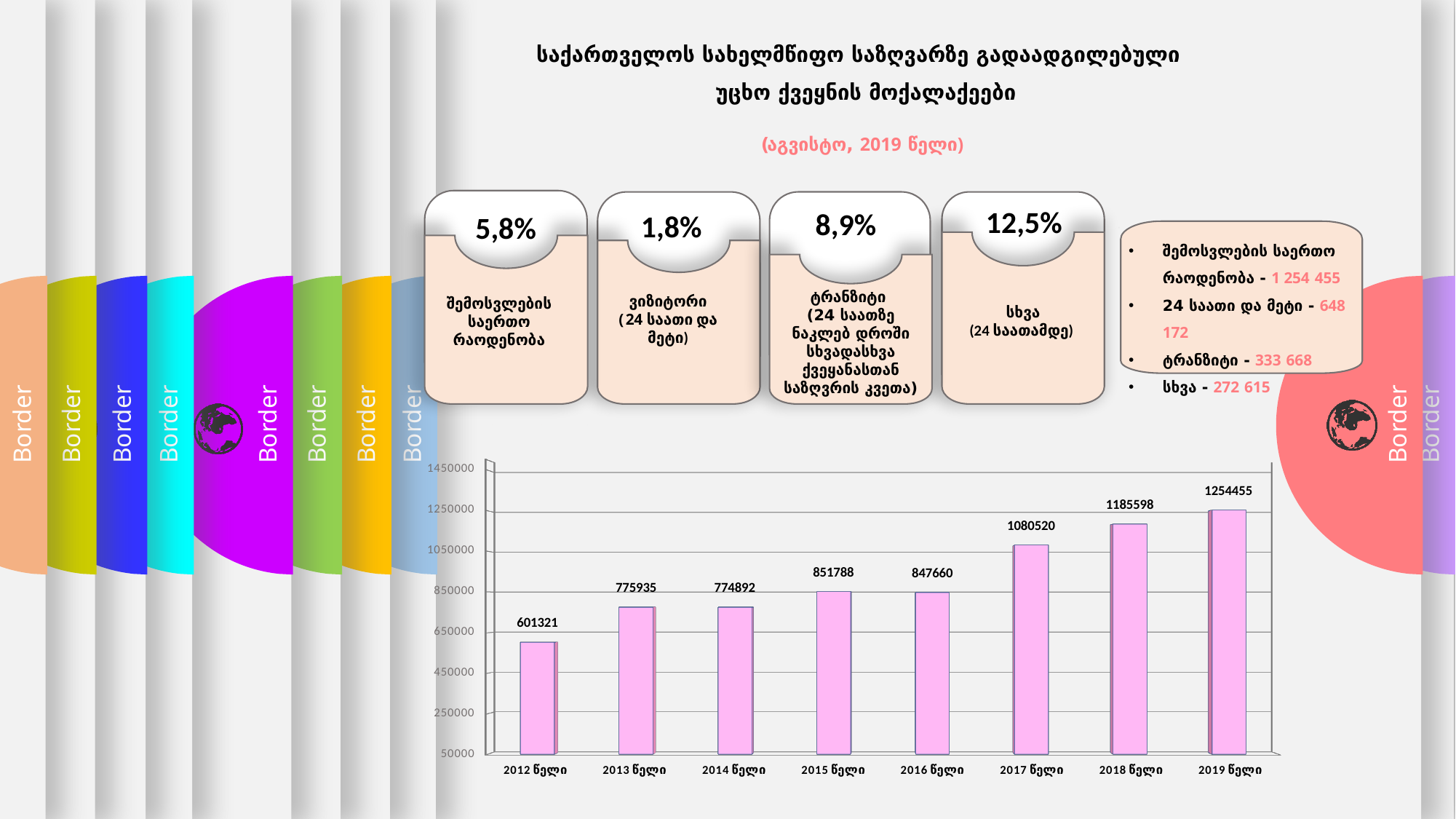
What is the difference between the values for 2019 წელი and 2018 წელი? 68857 What is the value shown for 2012 წელი in the bar chart? 601321 Which year has the lowest value in the bar chart? 2012 წელი Is the value for 2017 წელი greater or less than 1050000? greater Which year has the highest value in the bar chart? 2019 წელი What is the value shown for 2017 წელი in the bar chart? 1080520 What is the difference between the values for 2013 წელი and 2012 წელი? 174614 Which is larger, the value for 2015 წელი or the value for 2016 წელი? 2015 წელი What is the value shown for 2015 წელი in the bar chart? 851788 Do the values in the bar chart generally rise or fall from 2012 წელი to 2019 წელი? rise What kind of chart is shown at the bottom of the slide? bar chart How many years are shown on the x axis of the bar chart? 8